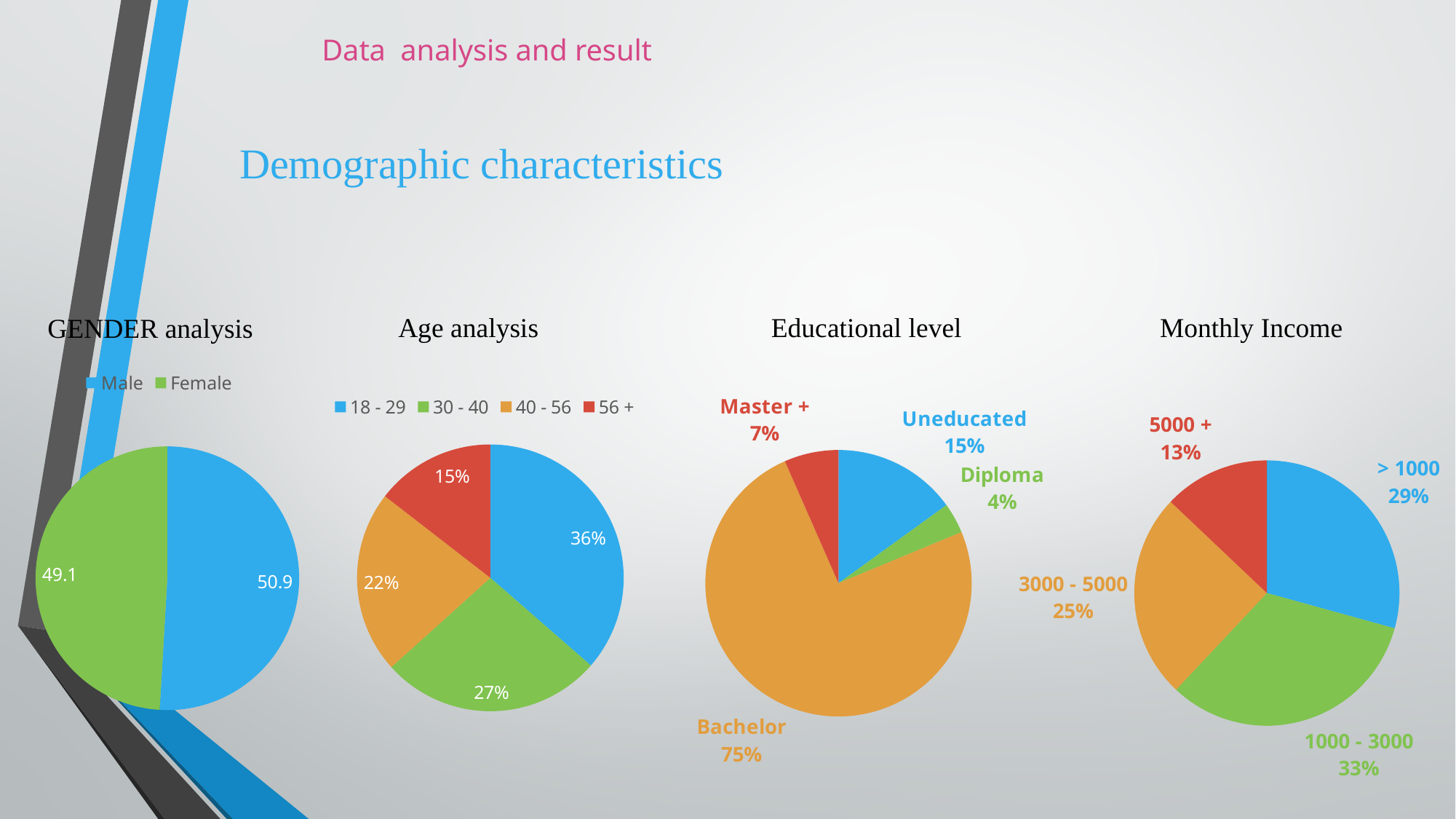
How many series does the legend of the Age analysis chart list? 4 In the Monthly Income chart, what is the share for 3000 - 5000? 25% In the Educational level chart, what is the share for Bachelor? 75% In the Monthly Income chart, which income group has the largest share? 1000 - 3000 In the GENDER analysis chart, what is the value for Female? 49.1 In the Age analysis chart, which age group has the smallest share? 56 + In the Age analysis chart, what is the difference between the 18 - 29 share and the 40 - 56 share? 14% In the Educational level chart, which is larger, Master + or Uneducated? Uneducated In the Educational level chart, which category has the smallest share? Diploma In the Age analysis chart, which age group has the largest share? 18 - 29 In the GENDER analysis chart, what is the value for Male? 50.9 In the Age analysis chart, what is the share for the 30 - 40 group? 27%